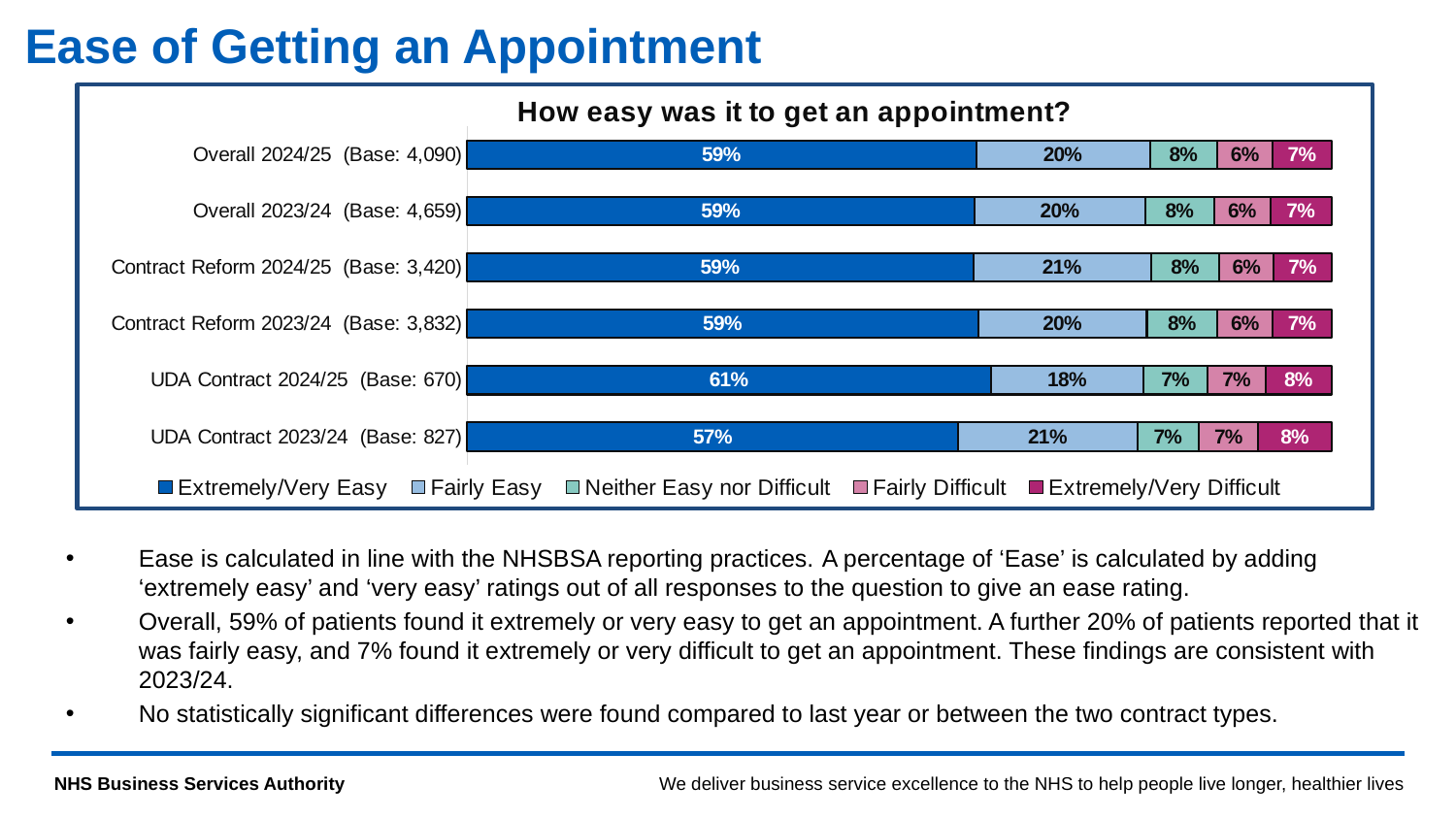
How many categories (bars) are shown in the chart? 6 Which category has the highest Extremely/Very Easy value? UDA Contract 2024/25 What is the difference between the Extremely/Very Easy values for UDA Contract 2024/25 and UDA Contract 2023/24? 4% How many series does the legend list? 5 What kind of chart is shown on the slide? Stacked bar chart What percentage of Overall 2024/25 respondents said Extremely/Very Easy? 59% What is the chart's title? How easy was it to get an appointment? What is the Neither Easy nor Difficult value for Contract Reform 2024/25? 8% What is the Fairly Easy value for UDA Contract 2024/25? 18% Which is larger: the Fairly Easy value for Contract Reform 2024/25 or for UDA Contract 2024/25? Contract Reform 2024/25 What is the Extremely/Very Difficult value for UDA Contract 2023/24? 8% Which category has the lowest Extremely/Very Easy value? UDA Contract 2023/24